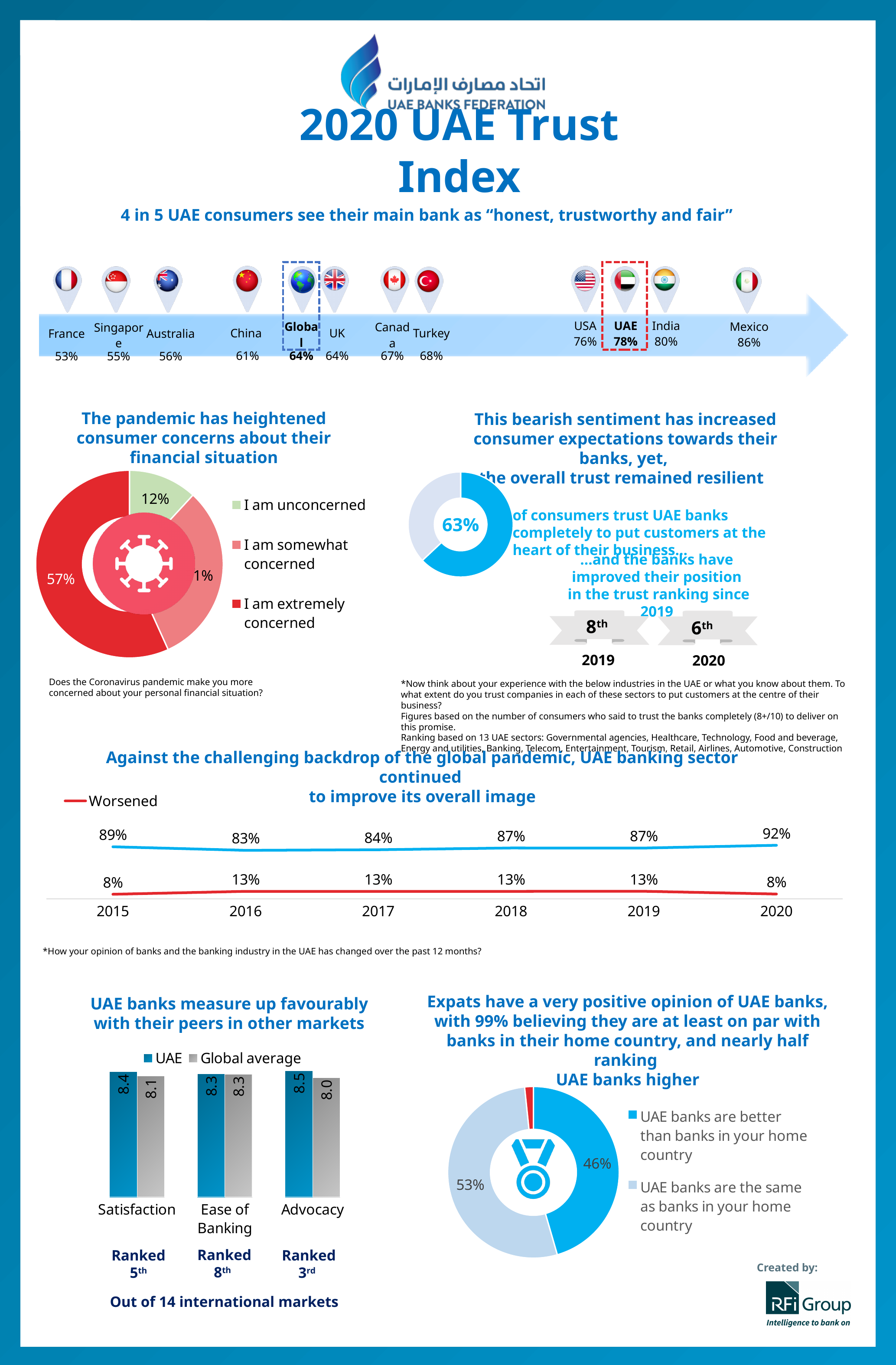
In the donut chart about expats' opinion of UAE banks, what share said UAE banks are better than banks in their home country? 46% In the line chart 'Against the challenging backdrop of the global pandemic, UAE banking sector continued to improve its overall image', what is the difference between the blue line values for 2020 and 2016? 9% In the line chart 'Against the challenging backdrop of the global pandemic, UAE banking sector continued to improve its overall image', how many years are shown on the x axis? 6 In the bar chart 'UAE banks measure up favourably with their peers in other markets', what is the Global average value for Advocacy? 8.0 In the bar chart 'UAE banks measure up favourably with their peers in other markets', what is the UAE value for Satisfaction? 8.4 In the bar chart 'UAE banks measure up favourably with their peers in other markets', which category has the highest UAE value? Advocacy In the bar chart 'UAE banks measure up favourably with their peers in other markets', how many series does the legend list? 2 In the bar chart 'UAE banks measure up favourably with their peers in other markets', what is the difference between the UAE and Global average values for Advocacy? 0.5 In the donut chart 'The pandemic has heightened consumer concerns about their financial situation', what share of respondents said 'I am extremely concerned'? 57% In the line chart 'Against the challenging backdrop of the global pandemic, UAE banking sector continued to improve its overall image', which year has the highest value on the blue line? 2020 In the line chart 'Against the challenging backdrop of the global pandemic, UAE banking sector continued to improve its overall image', what is the Worsened value for 2018? 13% In the bar chart 'UAE banks measure up favourably with their peers in other markets', how many categories are shown? 3